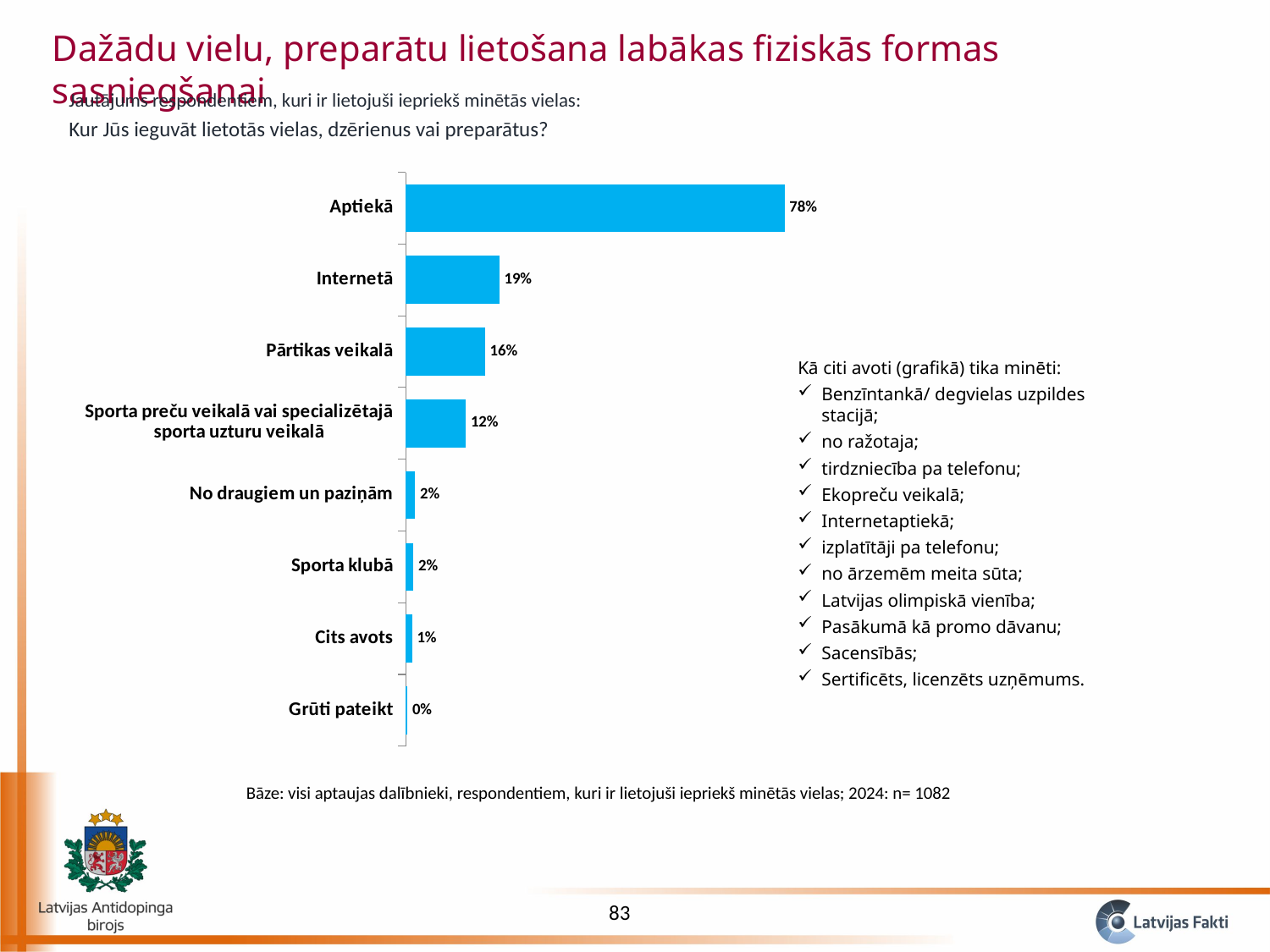
What colour are the bars in the chart? Blue What is the value for Aptiekā? 78% Which category has the highest value? Aptiekā What is the value for Sporta preču veikalā vai specializētajā sporta uzturu veikalā? 12% Which category has the lowest value? Grūti pateikt What is the value for Cits avots? 1% What is the value for Internetā? 19% Which is larger, the value for Pārtikas veikalā or the value for Sporta preču veikalā vai specializētajā sporta uzturu veikalā? Pārtikas veikalā How many categories are shown in the chart? 8 What is the difference between the values for Aptiekā and Internetā? 59% What is the difference between the values for Internetā and Pārtikas veikalā? 3% What kind of chart is shown on the slide? Bar chart